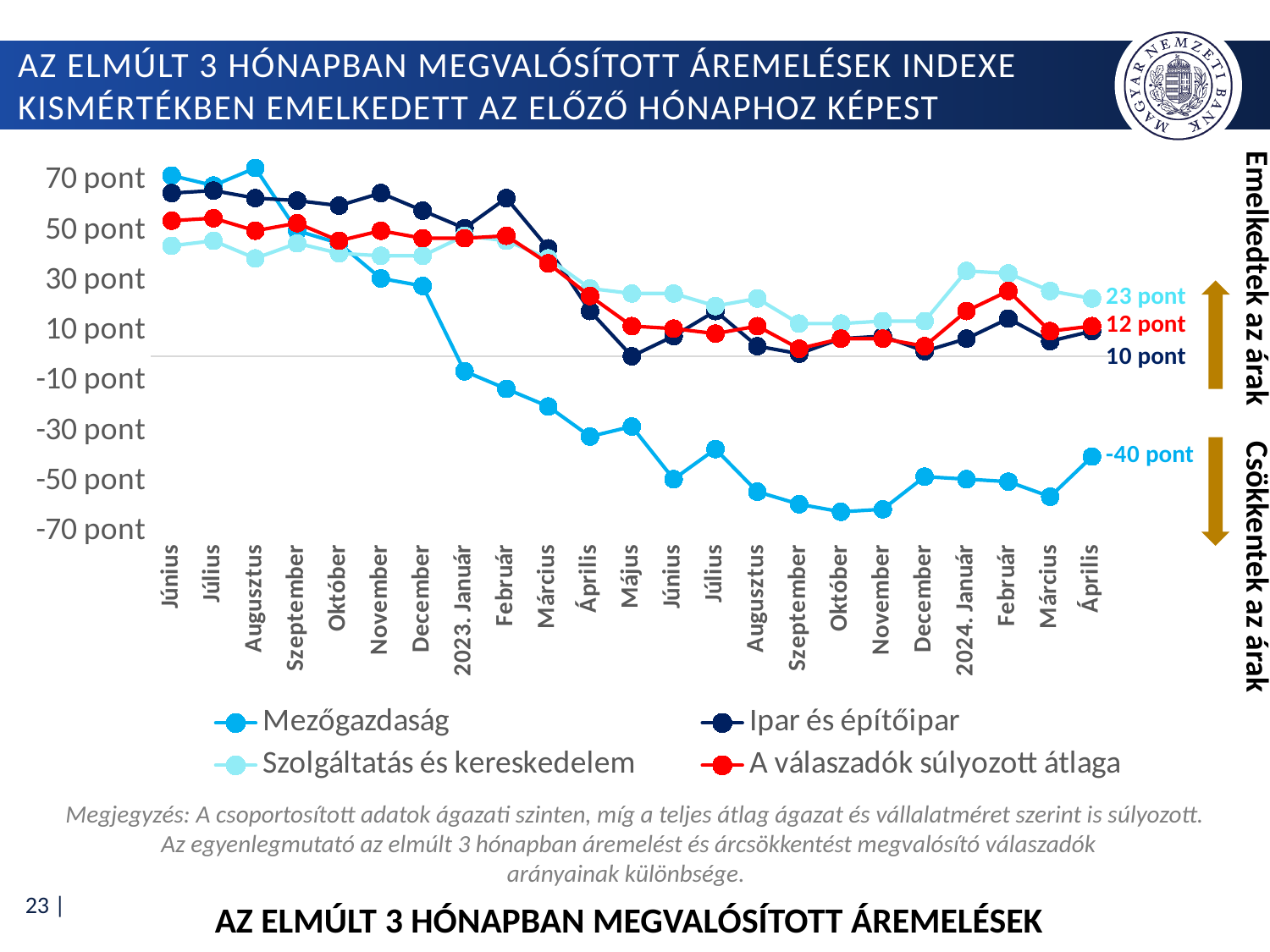
What is the value for Mezőgazdaság in Április 2024? -40 pont How many series does the legend list? 4 What is the difference between the Április 2024 values of Szolgáltatás és kereskedelem and Mezőgazdaság? 63 pont What is the value for Ipar és építőipar in Április 2024? 10 pont Is the value for Mezőgazdaság in Október 2023 greater or less than -50 pont? less Which series has the highest value in Április 2024? Szolgáltatás és kereskedelem Which series is drawn in red? A válaszadók súlyozott átlaga What is the value for Szolgáltatás és kereskedelem in Április 2024? 23 pont Which series has the lowest value in Április 2024? Mezőgazdaság What is the value for A válaszadók súlyozott átlaga in Április 2024? 12 pont Does the Mezőgazdaság series rise or fall from Június 2022 to Április 2024? fall What kind of chart is shown on the slide? line chart